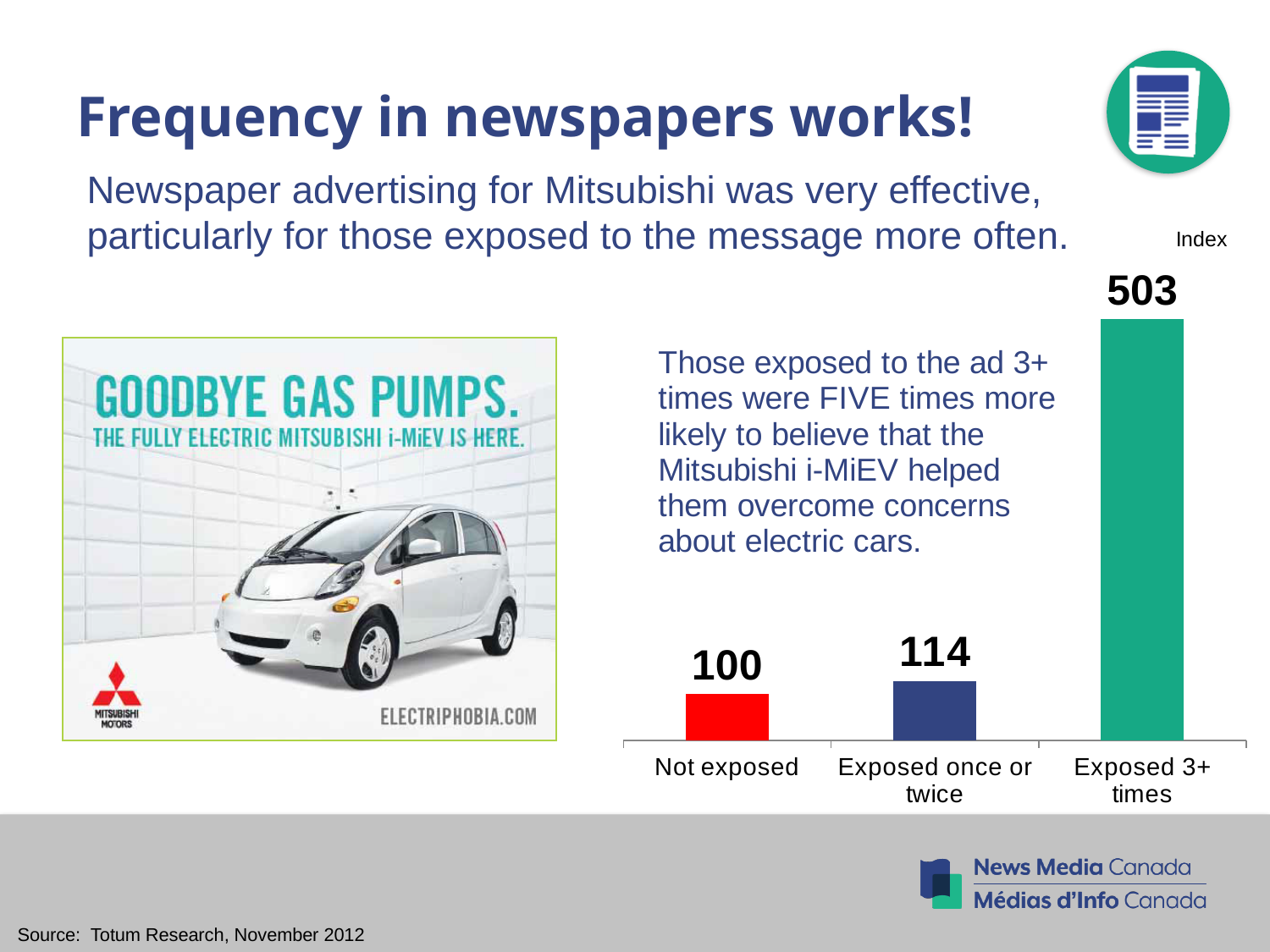
What colour is the bar for 'Exposed 3+ times'? Green Which category has the highest index value? Exposed 3+ times Which is larger, the index for 'Exposed once or twice' or for 'Exposed 3+ times'? Exposed 3+ times What is the index value for the 'Exposed once or twice' group? 114 Do the index values rise or fall from left to right across the categories? Rise How many categories are shown on the chart? 3 What is the difference between the index values for 'Exposed once or twice' and 'Not exposed'? 14 What is the index value for the 'Exposed 3+ times' group? 503 Which category has the lowest index value? Not exposed What is the index value for the 'Not exposed' group? 100 What kind of chart is shown on the slide? Bar chart What is the difference between the index values for 'Exposed 3+ times' and 'Not exposed'? 403